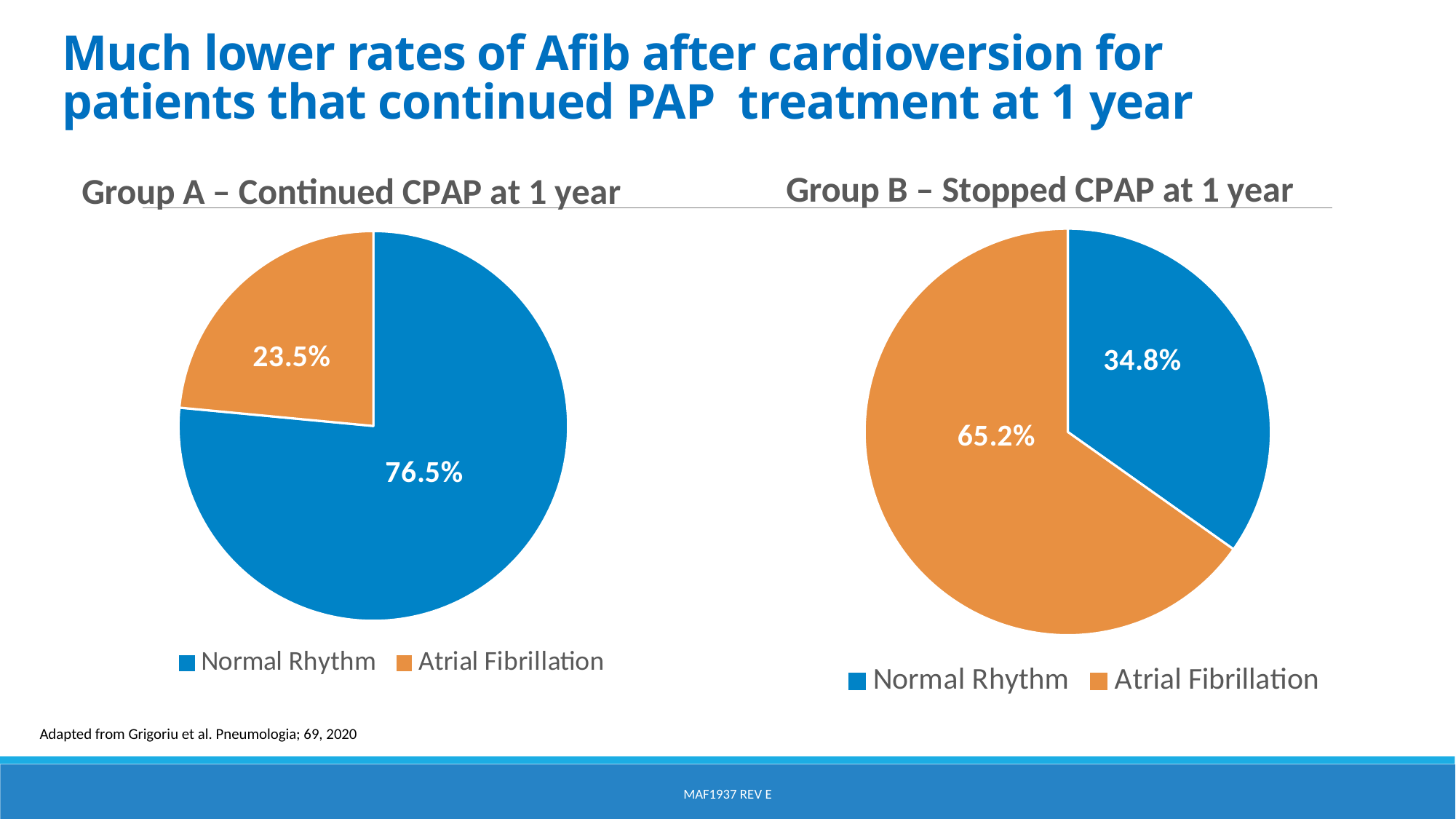
In the Group A – Continued CPAP at 1 year chart, what percentage of patients had Atrial Fibrillation? 23.5% How many slices does the Group B – Stopped CPAP at 1 year pie chart have? 2 In the Group A – Continued CPAP at 1 year chart, what percentage of patients had Normal Rhythm? 76.5% What is the difference between the Atrial Fibrillation share in the Group B chart and the Atrial Fibrillation share in the Group A chart? 41.7% In the Group B – Stopped CPAP at 1 year chart, what percentage of patients had Normal Rhythm? 34.8% In the Group A – Continued CPAP at 1 year chart, which category has the largest slice? Normal Rhythm In the Group B – Stopped CPAP at 1 year chart, what colour represents Atrial Fibrillation? Orange In the Group B – Stopped CPAP at 1 year chart, which category has the smallest slice? Normal Rhythm What type of chart is used for Group A – Continued CPAP at 1 year? Pie chart In the Group B – Stopped CPAP at 1 year chart, what percentage of patients had Atrial Fibrillation? 65.2% How many entries does the legend of the Group A – Continued CPAP at 1 year chart list? 2 Which chart shows a larger Normal Rhythm share, Group A – Continued CPAP at 1 year or Group B – Stopped CPAP at 1 year? Group A – Continued CPAP at 1 year